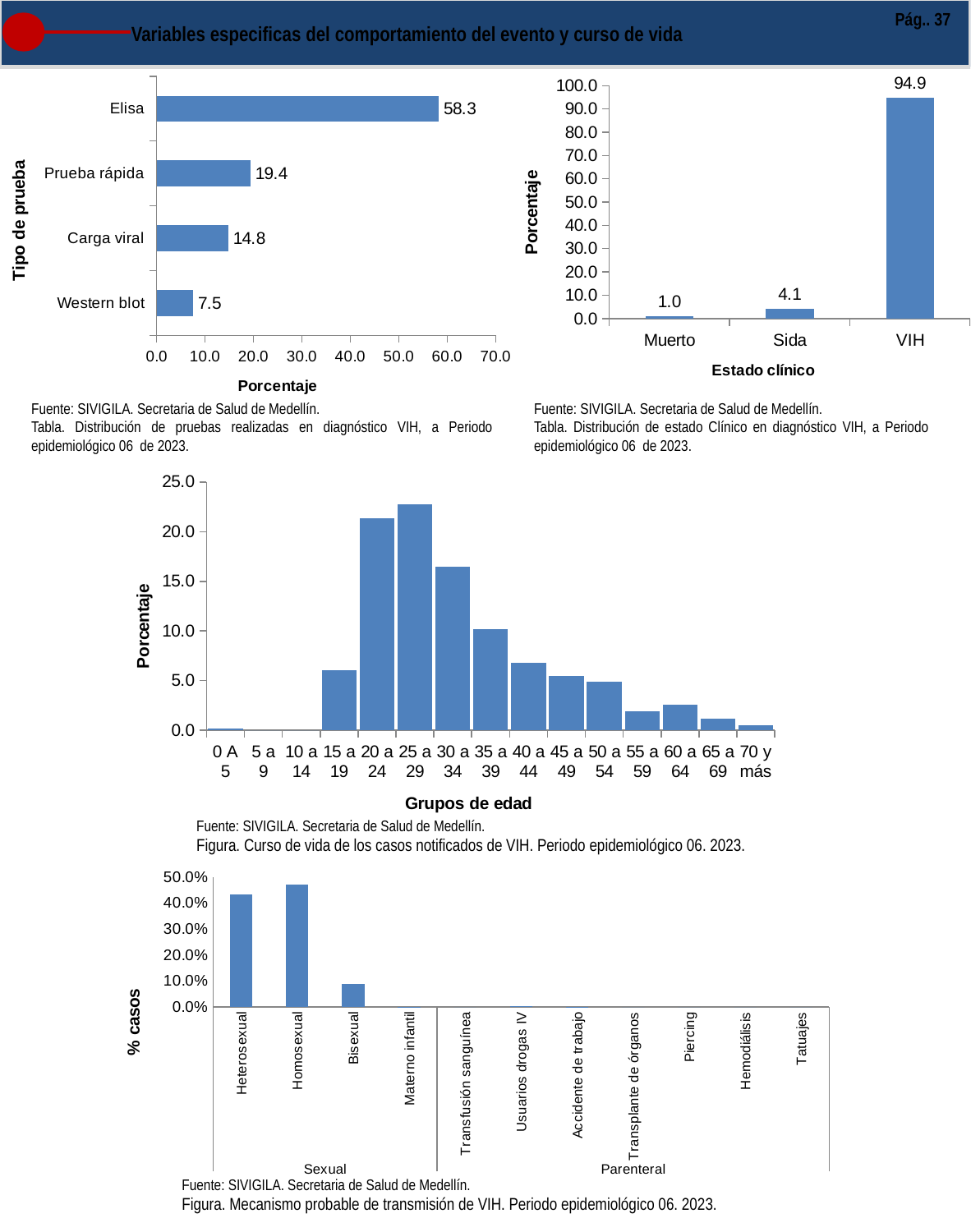
In the middle chart (Grupos de edad), is the value for 30 a 34 greater or less than 15.0? greater In the bottom chart (% casos), which transmission mechanism has the highest value? Homosexual In the middle chart (Grupos de edad), how many age groups are shown on the x axis? 15 In the top-right chart (Estado clínico), what is the value for Sida? 4.1 In the top-left chart (Tipo de prueba), which type of test has the lowest value? Western blot What kind of chart is the top-left chart (Tipo de prueba)? bar chart In the top-left chart (Tipo de prueba), what is the value for Elisa? 58.3 In the top-right chart (Estado clínico), what is the difference between VIH and Muerto? 93.9 In the bottom chart (% casos), is the value for Bisexual greater or less than 10.0%? less In the top-right chart (Estado clínico), which clinical state has the highest value? VIH In the top-left chart (Tipo de prueba), what is the difference between Prueba rápida and Carga viral? 4.6 In the middle chart (Grupos de edad), which age group has the highest value? 25 a 29